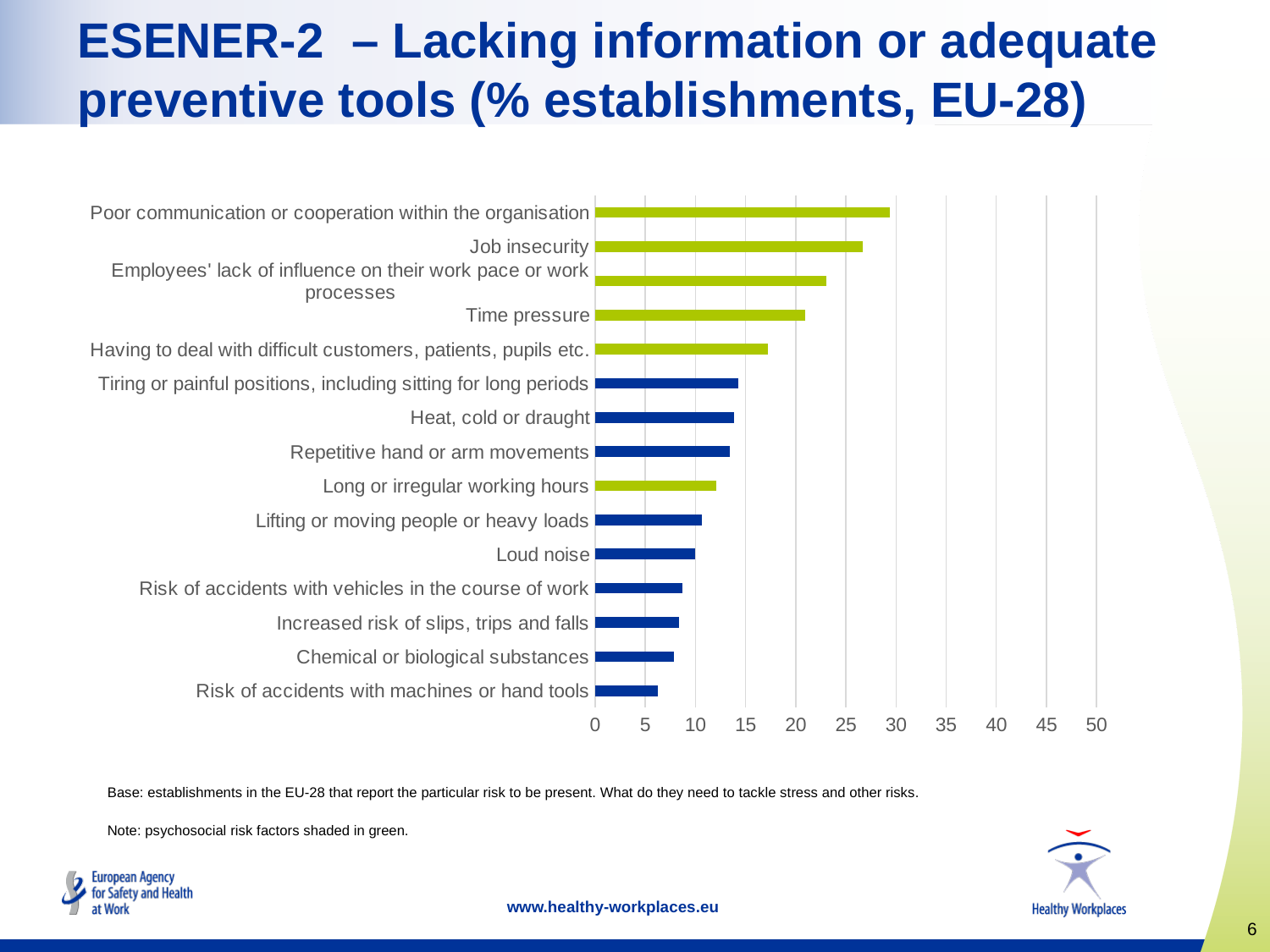
How many categories are plotted in the chart? 15 Is the value for Poor communication or cooperation within the organisation greater or less than 25? greater What kind of chart is shown on the slide? bar chart According to the note on the slide, what colour are the psychosocial risk factors shaded in the chart? green Which category has the lowest value in the chart? Risk of accidents with machines or hand tools Is the value for Having to deal with difficult customers, patients, pupils etc. greater or less than 15? greater Which is larger, the value for Job insecurity or the value for Time pressure? Job insecurity Is the value for Risk of accidents with machines or hand tools greater or less than 10? less Which category has the highest value in the chart? Poor communication or cooperation within the organisation Which is larger, the value for Lifting or moving people or heavy loads or the value for Chemical or biological substances? Lifting or moving people or heavy loads